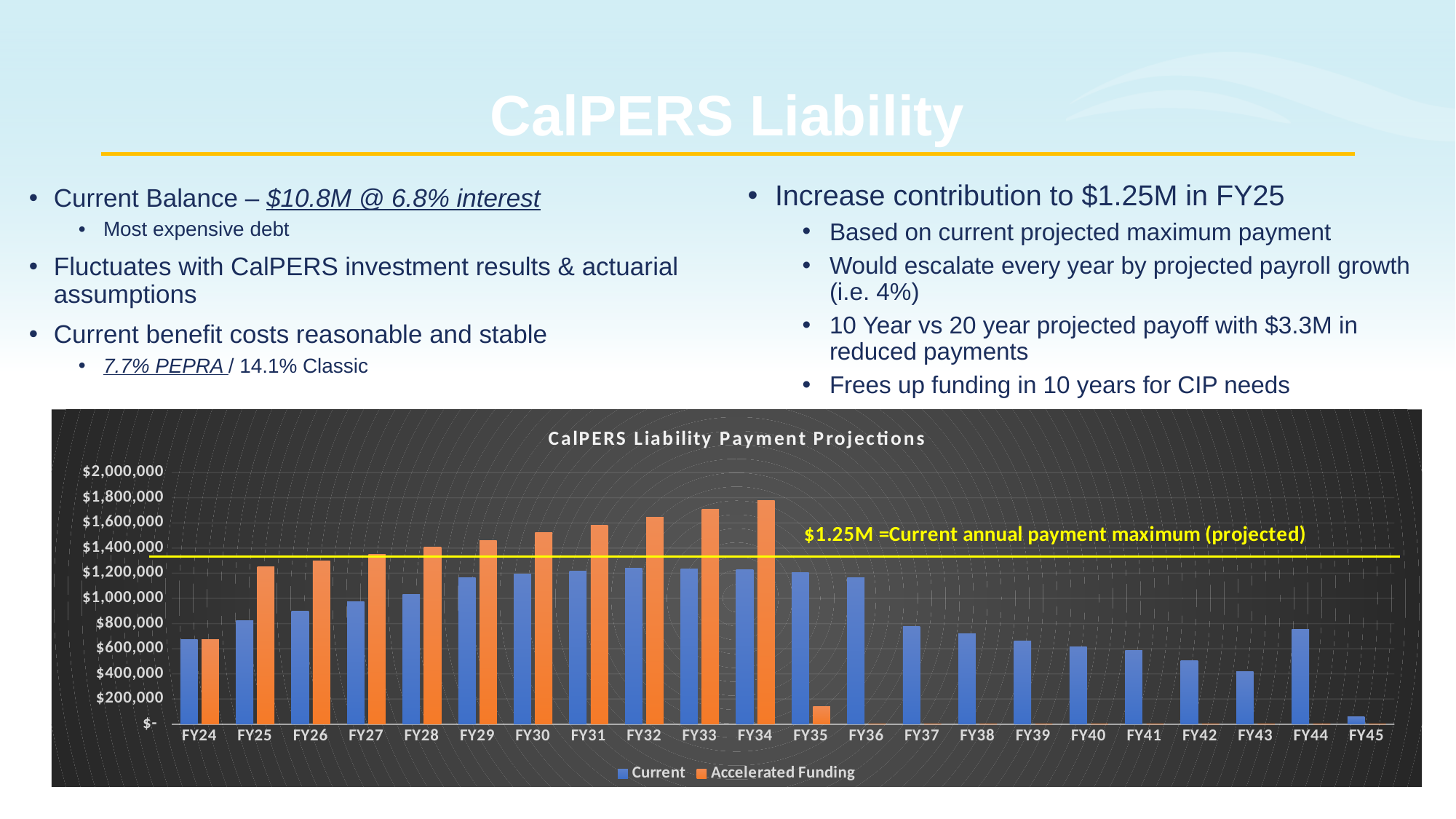
How many series does the chart legend list? 2 Is the Accelerated Funding value for FY35 greater or less than $200,000? less What kind of chart is shown on the slide? bar chart In which fiscal year is the Current bar lowest? FY45 Is the Accelerated Funding value for FY34 greater or less than $1,600,000? greater What is the title of the chart on the slide? CalPERS Liability Payment Projections For FY30, which is larger: the Current bar or the Accelerated Funding bar? Accelerated Funding What are the two series named in the chart legend? Current and Accelerated Funding In which fiscal year is the Accelerated Funding bar highest? FY34 Do the Accelerated Funding values rise or fall from FY24 to FY34? rise How many fiscal years are shown on the x axis of the chart? 22 Is the Current value for FY36 greater or less than $1,000,000? greater